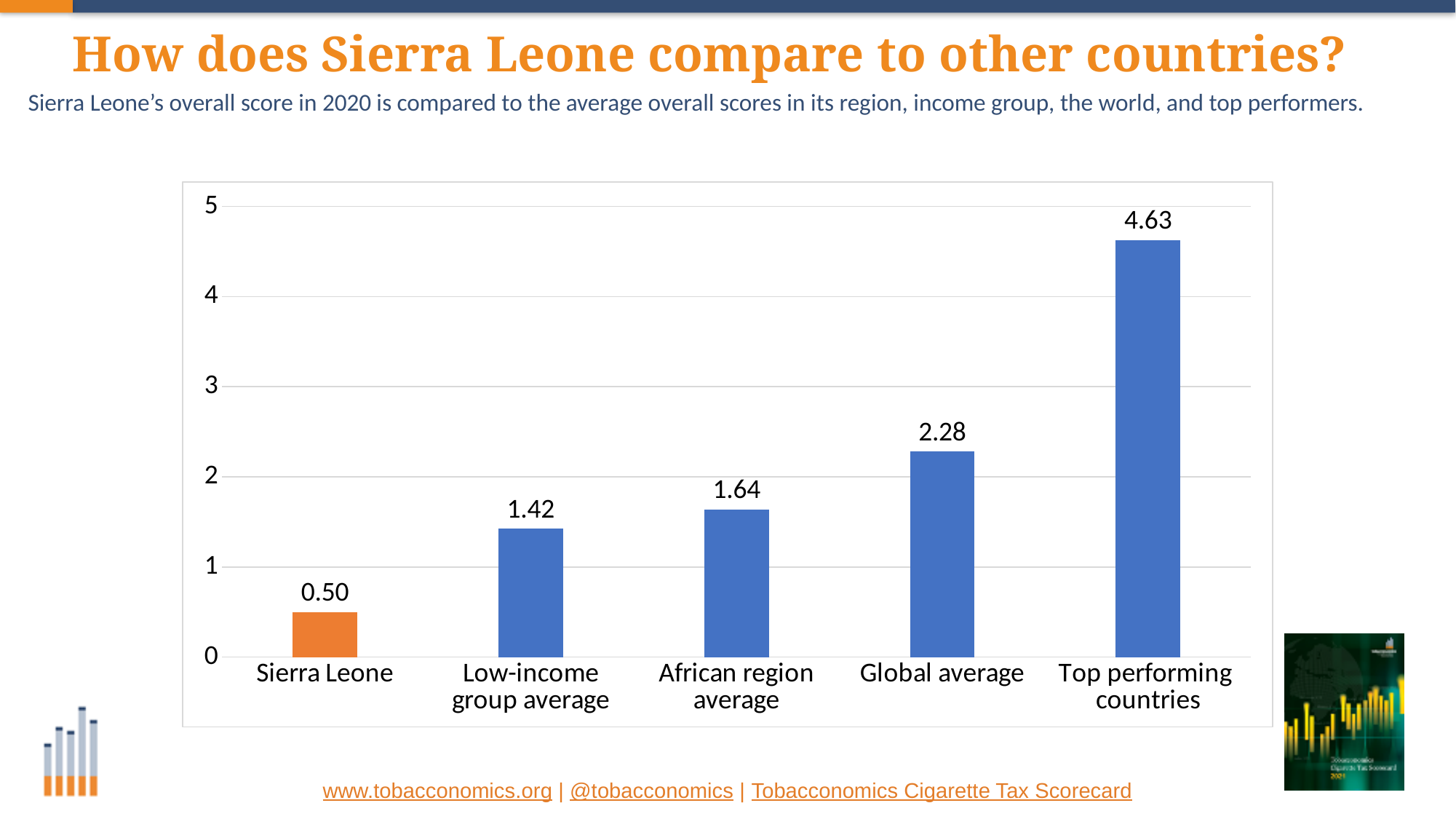
Is the value for the Global average greater or less than 2? greater Which is larger, the Global average or the African region average? Global average What is the value for Sierra Leone? 0.50 What is the value for the Global average? 2.28 Which category has the highest value? Top performing countries What is the value for the African region average? 1.64 What is the difference between the value for Top performing countries and the value for Sierra Leone? 4.13 Which category has the lowest value? Sierra Leone What is the value for the Low-income group average? 1.42 What is the value for Top performing countries? 4.63 What kind of chart is shown on the slide? Bar chart How many categories are shown on the chart? 5